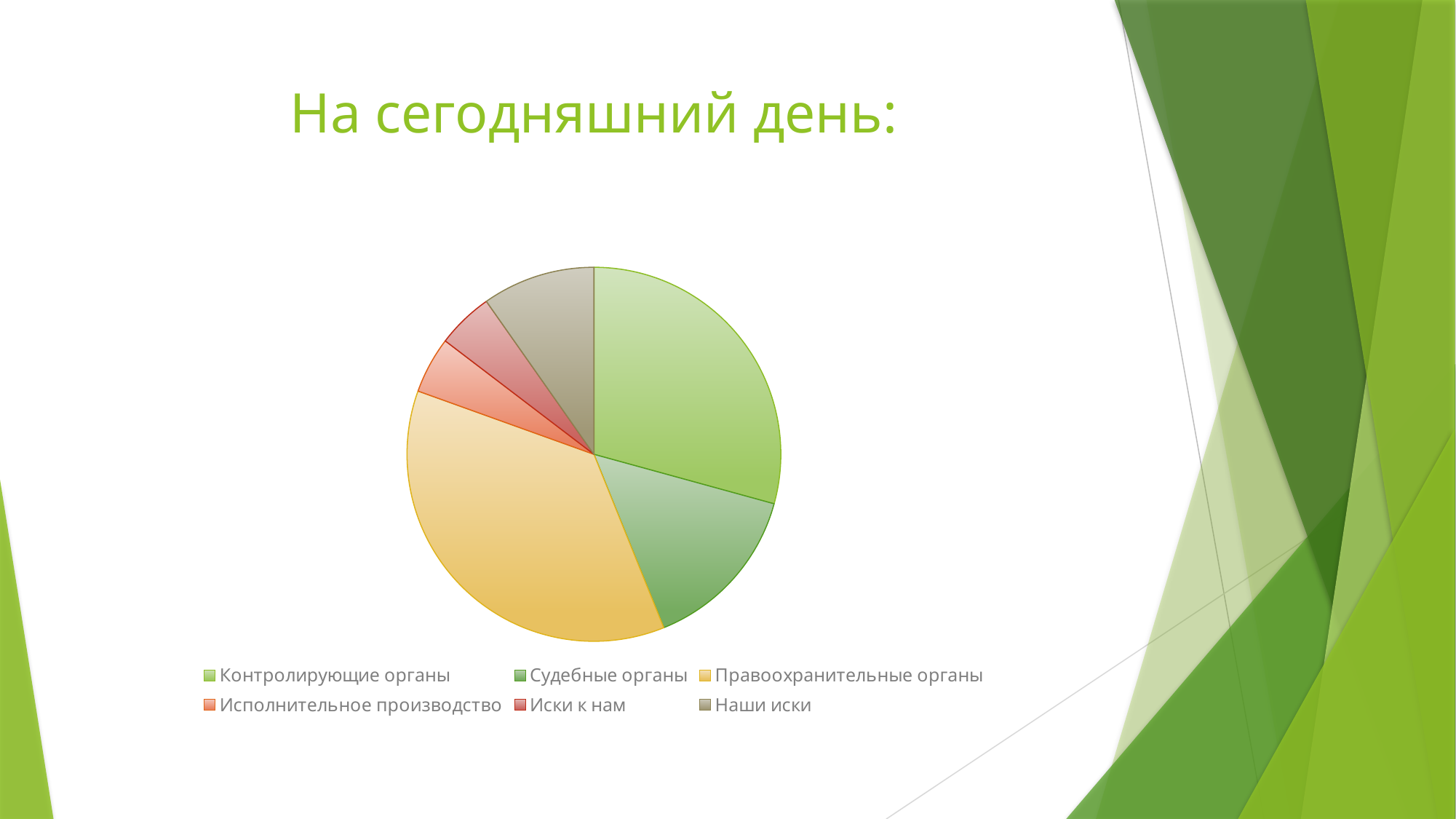
Which slice is larger: Контролирующие органы or Судебные органы? Контролирующие органы How many categories (slices) does the pie chart have? 6 What colour is the slice for Правоохранительные органы in the pie chart? yellow Which slice is larger: Наши иски or Иски к нам? Наши иски What kind of chart is shown on the slide? pie chart What is the title of the slide containing the pie chart? На сегодняшний день: How many entries does the legend of the pie chart list? 6 Which category has the largest slice of the pie chart? Правоохранительные органы Which slice is larger: Правоохранительные органы or Контролирующие органы? Правоохранительные органы